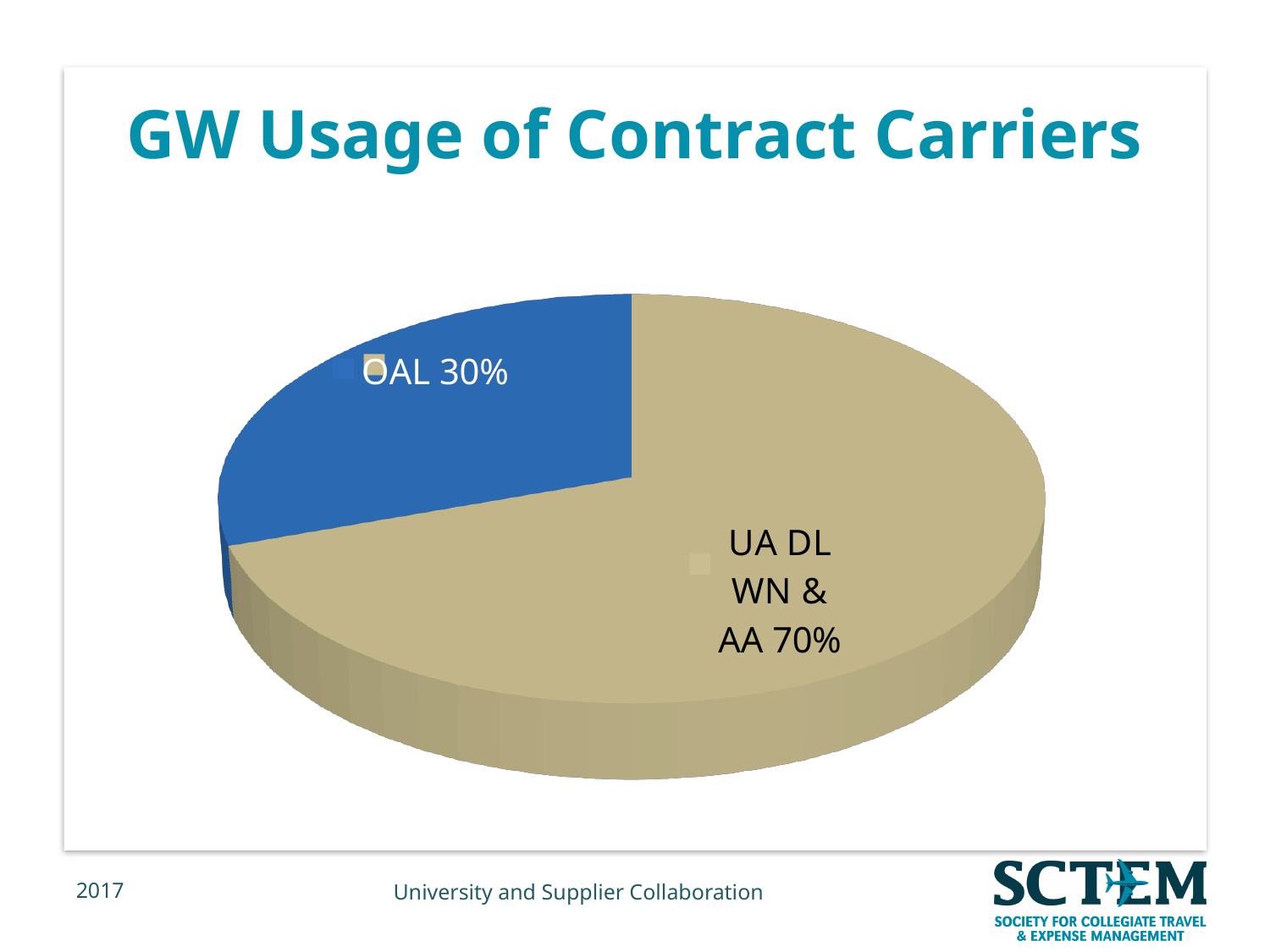
What is the title of the chart? GW Usage of Contract Carriers What is the difference in percentage points between the UA DL WN & AA slice and the OAL slice? 40 Which slice is the largest? UA DL WN & AA What share of the pie does OAL represent? 30% How many slices does the pie chart have? 2 What kind of chart is shown on the slide? Pie chart What share of the pie does UA DL WN & AA represent? 70% Which slice is the smallest? OAL Which is larger, the OAL slice or the UA DL WN & AA slice? UA DL WN & AA What colour is the OAL slice? Blue